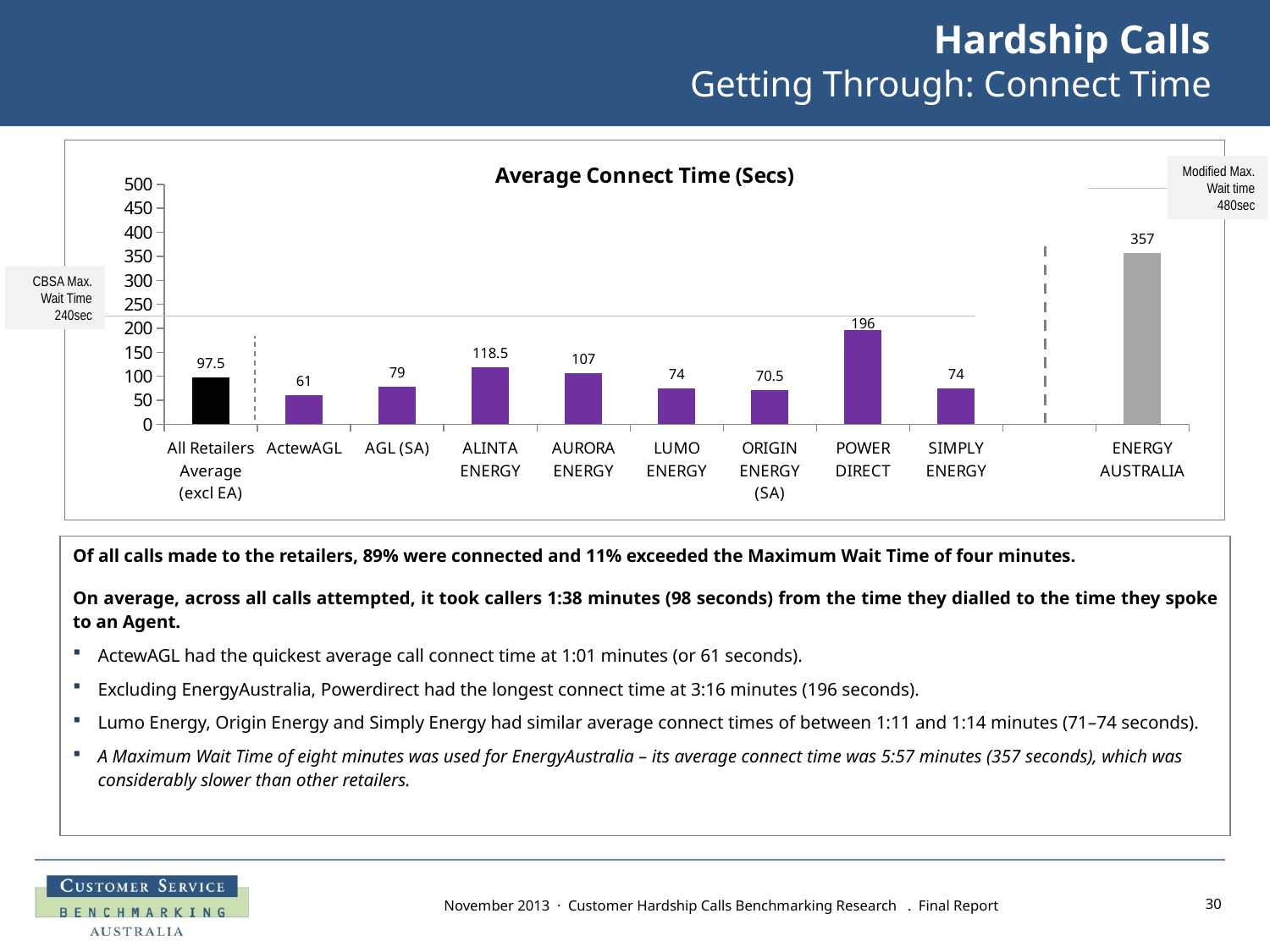
Which retailer has the lowest average connect time? ActewAGL Which retailer has the highest average connect time? ENERGY AUSTRALIA What is the difference between the average connect times of ALINTA ENERGY and AURORA ENERGY? 11.5 What is the average connect time for ActewAGL? 61 What is the title of the chart? Average Connect Time (Secs) Which has a higher average connect time, AGL (SA) or ORIGIN ENERGY (SA)? AGL (SA) What is the average connect time for ENERGY AUSTRALIA? 357 Is the value for POWER DIRECT greater or less than 150? greater How many bars are plotted in the chart? 10 What is the value shown for All Retailers Average (excl EA)? 97.5 What is the average connect time for POWER DIRECT? 196 What type of chart is shown on the slide? Bar chart